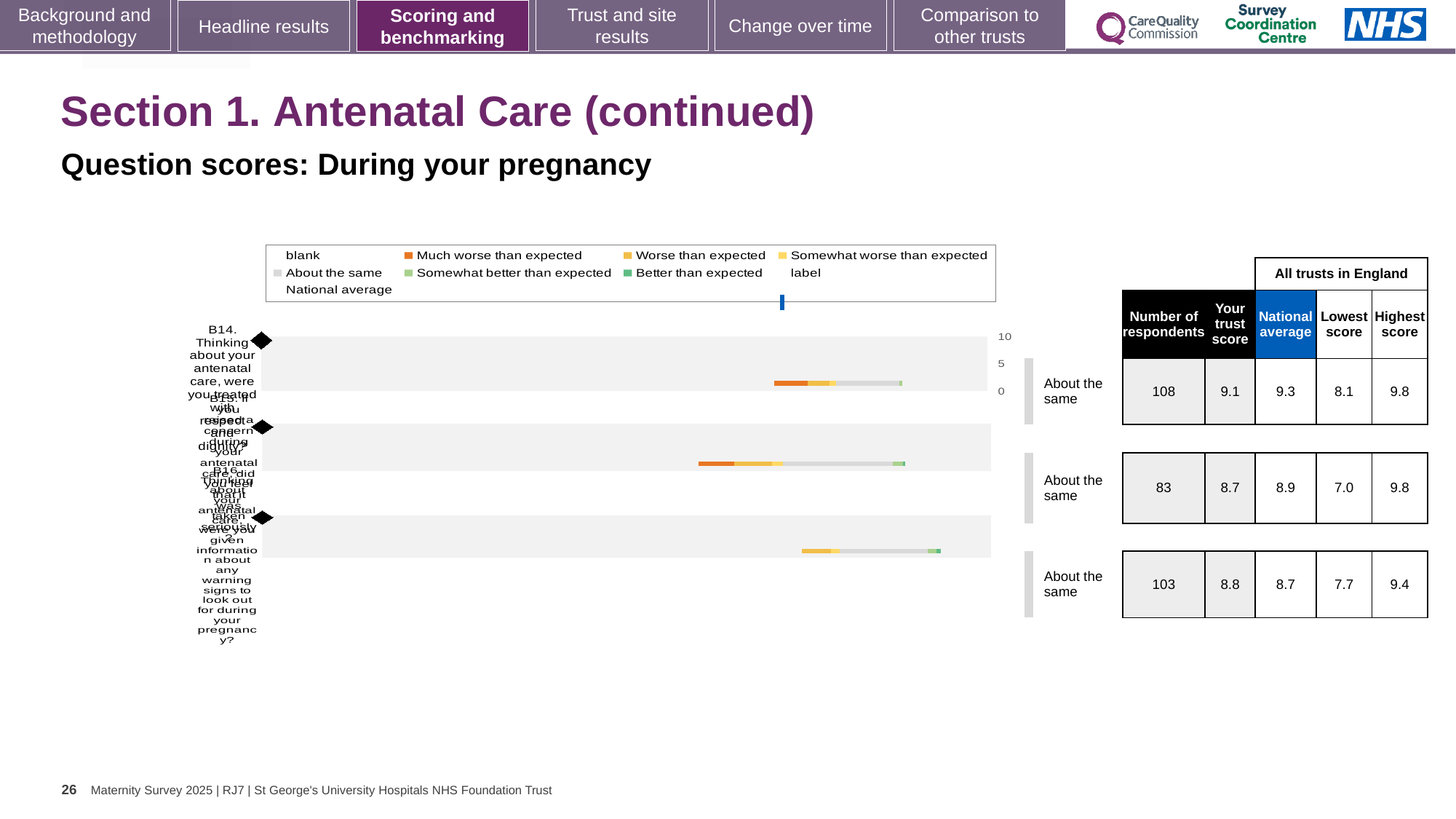
In the table beside the chart, what is the highest score for the third question (B16)? 9.4 In the table beside the chart, which question has the lowest 'Lowest score' value? B15 In the table beside the chart, which question has the most respondents? B14 In the table beside the chart, what is the national average for the second question (B15)? 8.9 How many question bars are plotted in the chart? 3 What benchmark category is shown next to each of the three bars? About the same What kind of chart is shown on the slide? bar chart In the table beside the chart, what is the difference between the trust score and the national average for the first question (B14)? 0.2 What is the subtitle of the chart section on the slide? Question scores: During your pregnancy In the table beside the chart, what is the trust score for the first question (B14)? 9.1 In the table beside the chart, is the trust score for the third question (B16) larger or smaller than its national average? larger In the table beside the chart, what is the number of respondents for the first question (B14)? 108